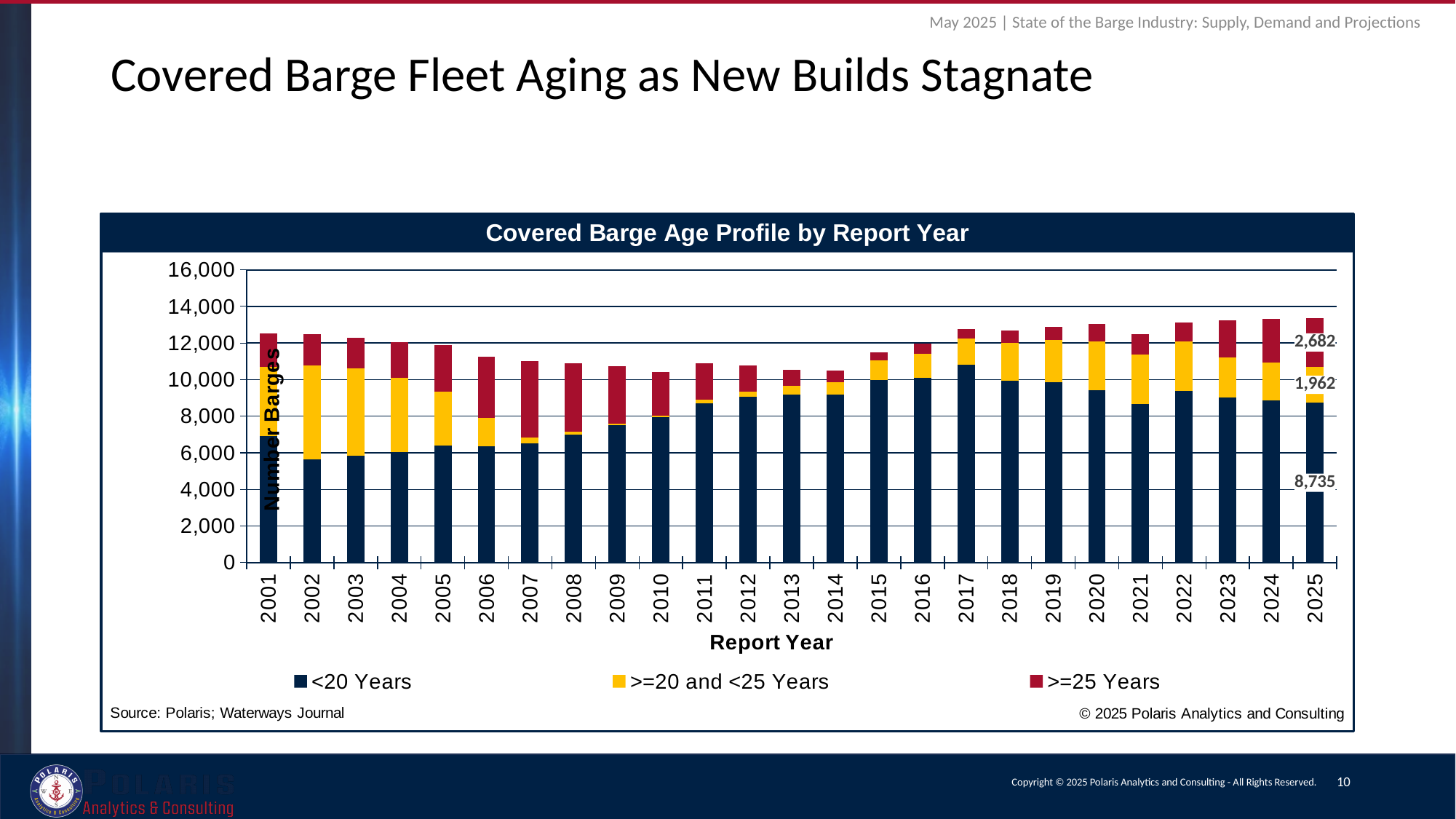
In 2025, which is larger: the >=20 and <25 Years segment or the >=25 Years segment? >=25 Years In the Covered Barge Age Profile by Report Year chart, what is the value for <20 Years in 2025? 8,735 What kind of chart is shown on the slide? Stacked bar chart Does the total number of barges rise or fall from 2001 to 2010? Fall Which report year has the largest <20 Years segment? 2017 What is the total number of covered barges in the 2025 stacked bar? 13,379 Is the <20 Years value for 2017 greater or less than 10,000? greater In 2025, how much larger is the <20 Years segment than the >=25 Years segment? 6,053 What is the value for >=25 Years in 2025? 2,682 What is the value for >=20 and <25 Years in 2025? 1,962 How many report years are shown on the x axis? 25 How many series does the legend list? 3